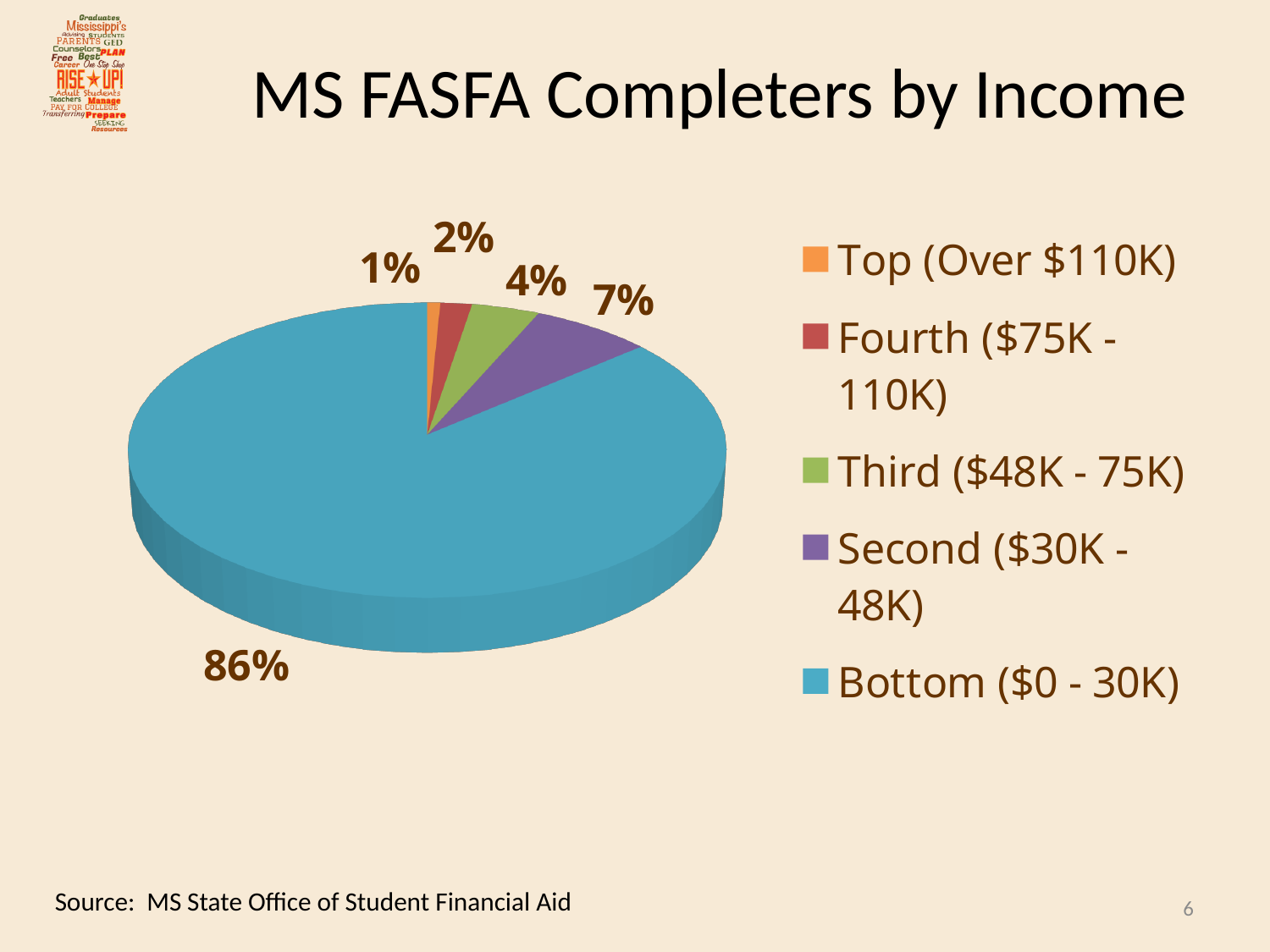
Which income group has the smallest share of MS FASFA completers? Top (Over $110K) What percentage of MS FASFA completers are in the Top (Over $110K) income group? 1% What percentage of MS FASFA completers are in the Fourth ($75K - 110K) income group? 2% How many income groups are shown in the pie chart? 5 What is the title of the chart? MS FASFA Completers by Income What is the difference in percentage points between the Bottom ($0 - 30K) and Second ($30K - 48K) groups? 79 What percentage of MS FASFA completers are in the Second ($30K - 48K) income group? 7% What kind of chart is shown on the slide? Pie chart Which income group has the largest share of MS FASFA completers? Bottom ($0 - 30K) Which is larger, the share for Third ($48K - 75K) or the share for Fourth ($75K - 110K)? Third ($48K - 75K) What percentage of MS FASFA completers are in the Third ($48K - 75K) income group? 4% What percentage of MS FASFA completers are in the Bottom ($0 - 30K) income group? 86%